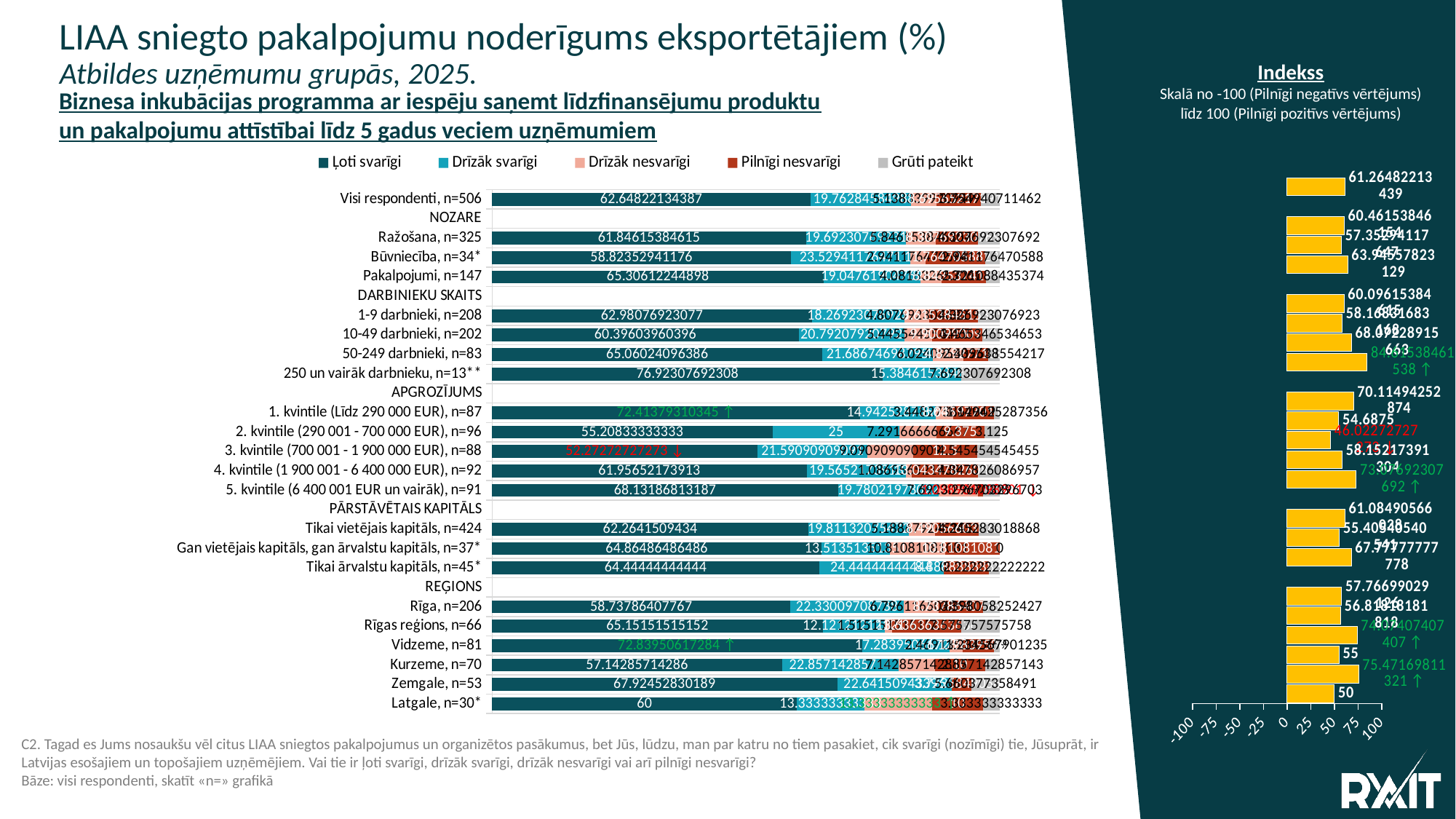
In the left chart, what is the 'Ļoti svarīgi' value for Latgale, n=30*? 60 In the Indekss chart on the right, which group has the lowest index value? 3. kvintile (700 001 - 1 900 000 EUR), n=88 In the Indekss chart on the right, what is the index value for Latgale, n=30*? 50 In the left chart, what is the 'Drīzāk svarīgi' value for 2. kvintile (290 001 - 700 000 EUR), n=96? 25 In the Indekss chart on the right, what is the index value for Kurzeme, n=70? 55 In the Indekss chart on the right, which group has the highest index value? 250 un vairāk darbinieku, n=13** In the Indekss chart on the right, what is the difference between the index values for Kurzeme, n=70 and Latgale, n=30*? 5 In the left chart, which group has the lowest 'Ļoti svarīgi' value? 3. kvintile (700 001 - 1 900 000 EUR), n=88 In the left chart, which group has the highest 'Ļoti svarīgi' value? 250 un vairāk darbinieku, n=13** What kind of chart is the main chart on the left of the slide? bar chart In the left chart, which has the larger 'Ļoti svarīgi' value: Vidzeme, n=81 or Kurzeme, n=70? Vidzeme, n=81 How many series does the legend of the left chart list? 5